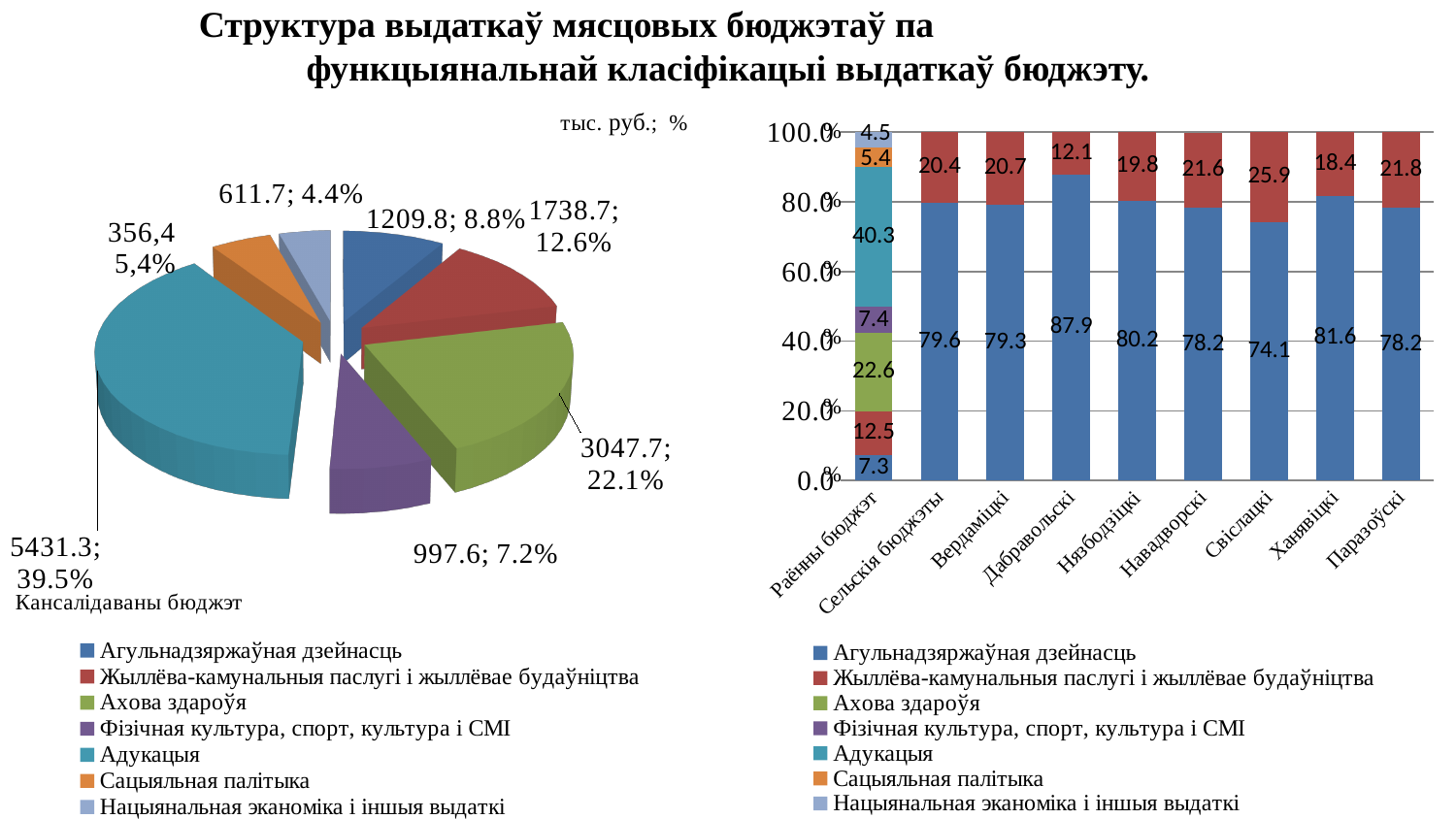
On the stacked bar chart on the right, what is the value of Агульнадзяржаўная дзейнасць for Дабравольскі? 87.9 How many series does the legend of the stacked bar chart on the right list? 7 On the stacked bar chart on the right, which budget has the highest value for Жыллёва-камунальныя паслугі і жыллёвае будаўніцтва? Свіслацкі On the pie chart on the left, which category has the smallest share? Нацыянальная эканоміка і іншыя выдаткі On the stacked bar chart on the right, how many categories are shown on the x axis? 9 On the pie chart on the left, what is the difference between the values for Ахова здароўя and Жыллёва-камунальныя паслугі і жыллёвае будаўніцтва? 1309 What type of chart is shown on the right side of the slide? Stacked bar chart On the stacked bar chart on the right, what is the value of Адукацыя for Раённы бюджэт? 40.3 On the pie chart on the left, which is larger: the value for Агульнадзяржаўная дзейнасць or for Фізічная культура, спорт, культура і СМІ? Агульнадзяржаўная дзейнасць On the pie chart on the left, which category has the largest slice? Адукацыя On the pie chart on the left, what share does Ахова здароўя have? 22.1% On the pie chart on the left, what value and share are shown for Адукацыя? 5431.3; 39.5%